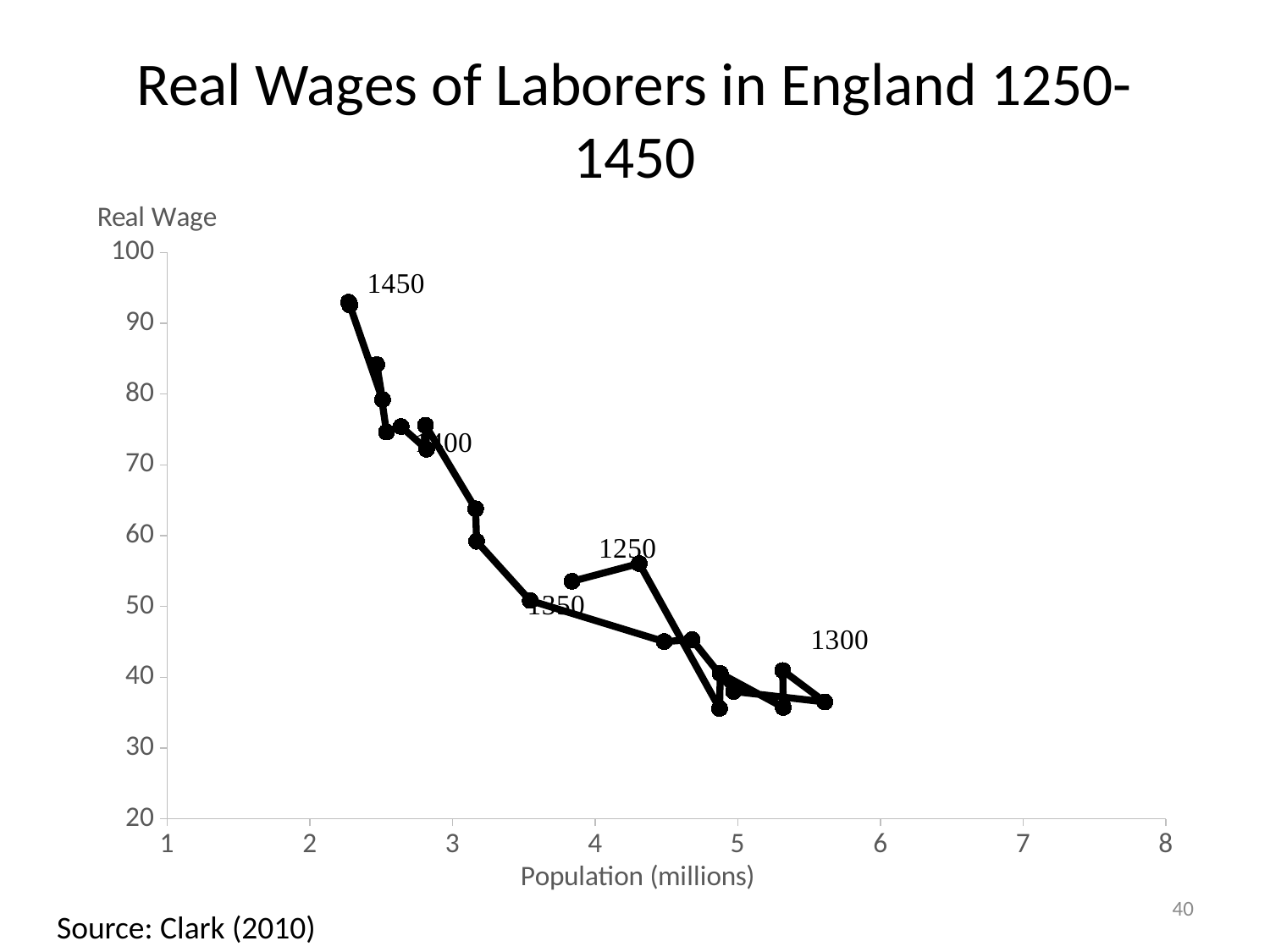
Is the population at the point labeled 1300 greater or less than 5 million? greater Is the real wage at the point labeled 1250 greater or less than 50? greater Which labeled year has the highest real wage? 1450 As population increases along the x axis, does the real wage generally rise or fall? fall Is the real wage at the point labeled 1450 greater or less than 90? greater What is the title of the chart? Real Wages of Laborers in England 1250-1450 Which has the higher real wage, the point labeled 1450 or the point labeled 1250? 1450 What kind of chart is shown on the slide? scatter chart What is the label of the horizontal axis? Population (millions)